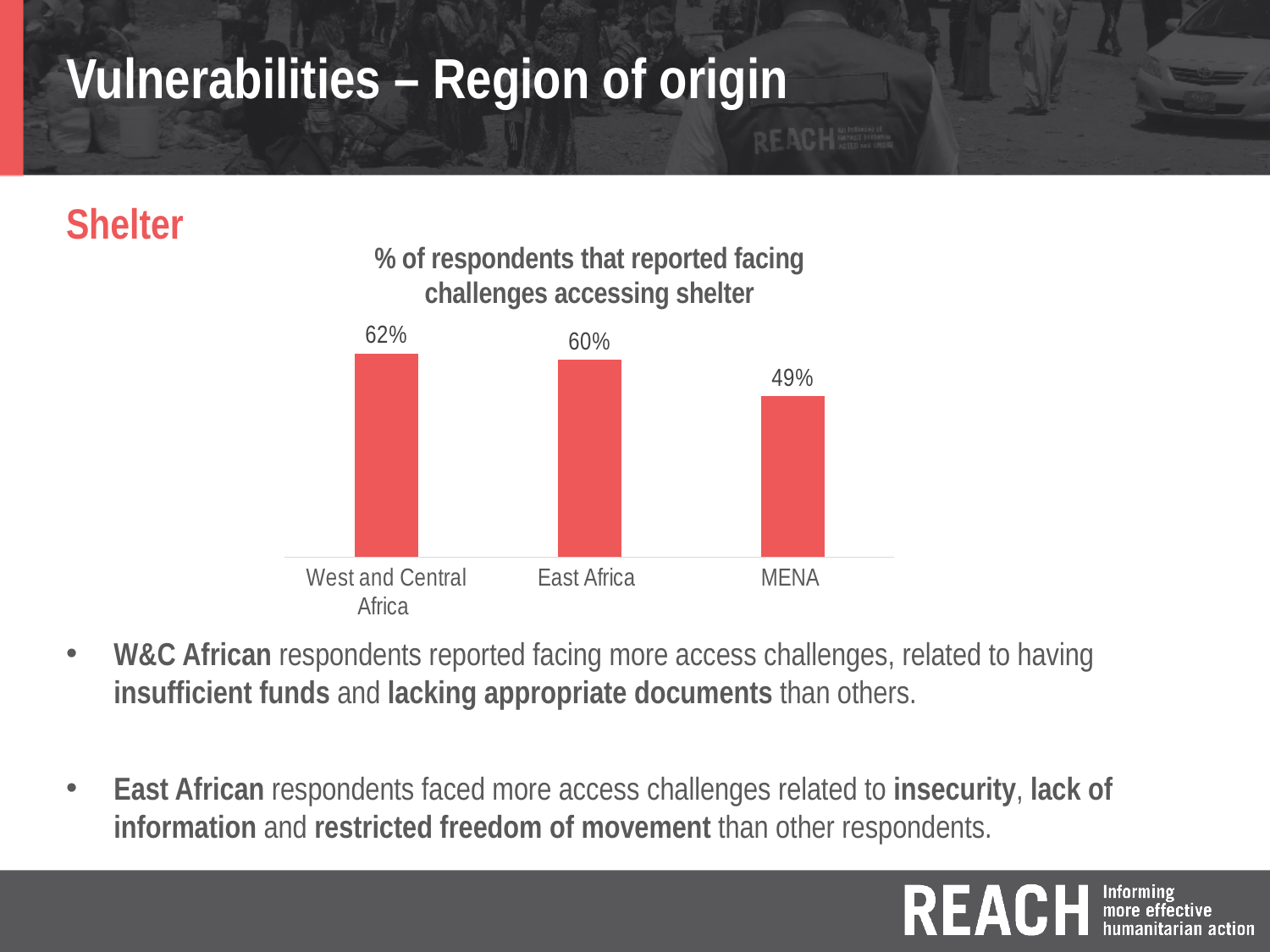
What percentage of respondents from West and Central Africa reported facing challenges accessing shelter? 62% What is the difference in percentage points between West and Central Africa and MENA? 13 percentage points What percentage of respondents from East Africa reported facing challenges accessing shelter? 60% What is the title of the chart? % of respondents that reported facing challenges accessing shelter How many regions of origin are shown in the chart? 3 What type of chart is used on the slide? Bar chart What is the difference in percentage points between East Africa and MENA? 11 percentage points What percentage of respondents from MENA reported facing challenges accessing shelter? 49% Which region of origin has the highest share of respondents reporting challenges accessing shelter? West and Central Africa Which has a higher value, East Africa or MENA? East Africa Do the values rise or fall moving from left to right across the chart? Fall Which region of origin has the lowest share of respondents reporting challenges accessing shelter? MENA